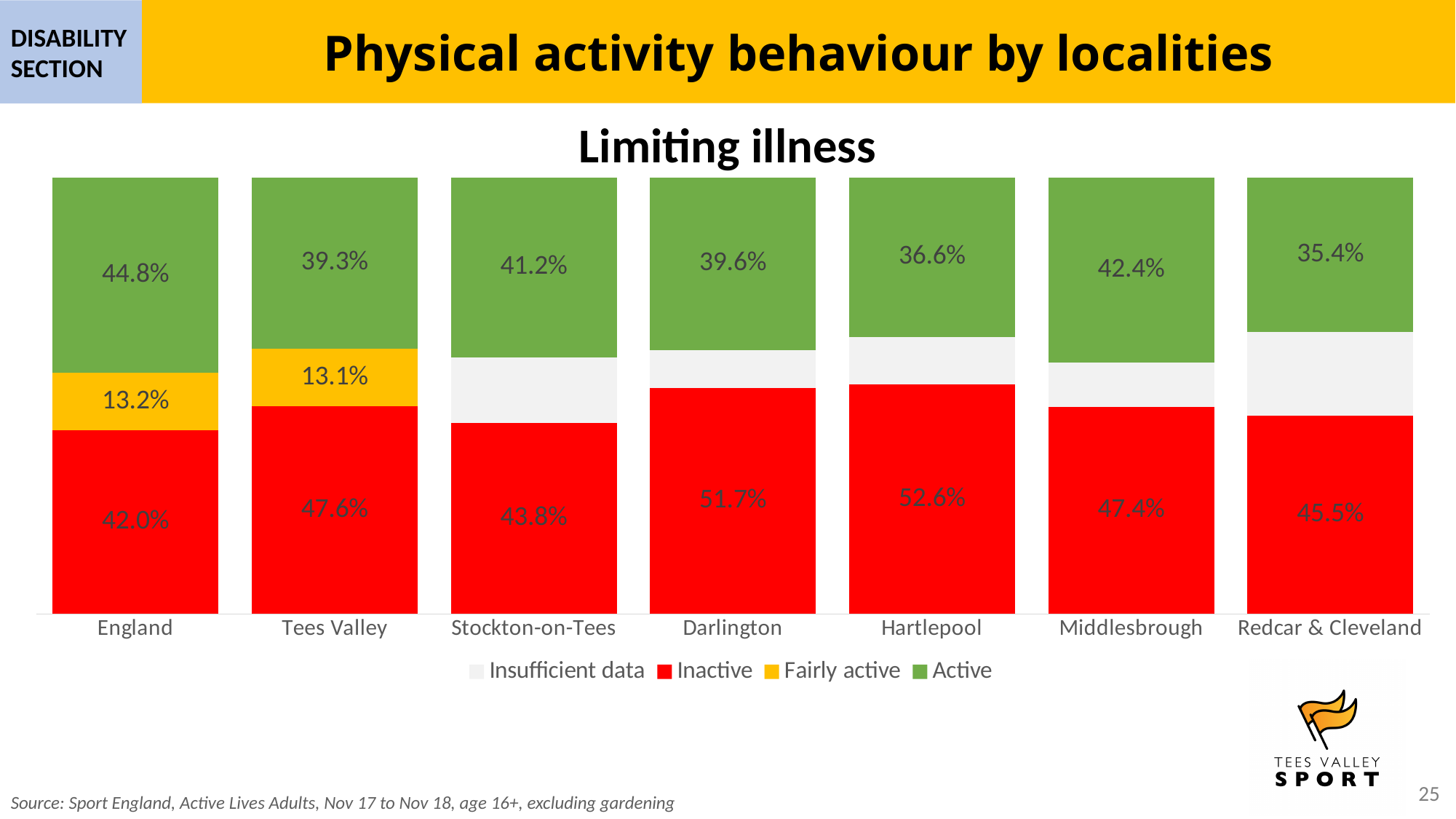
What is the total of the three labelled segments in the England bar? 100.0% What is the Inactive value for Darlington? 51.7% Which has a larger Active value, England or Tees Valley? England What is the Fairly active value for Tees Valley? 13.1% How many localities are shown on the x axis? 7 Which locality has the lowest Active value? Redcar & Cleveland What is the Active value for Middlesbrough? 42.4% Which locality has the highest Inactive value? Hartlepool What kind of chart is shown? Stacked bar chart How many series does the legend list? 4 What is the difference between the Inactive values for Hartlepool and England? 10.6 percentage points What is the title of the chart? Limiting illness